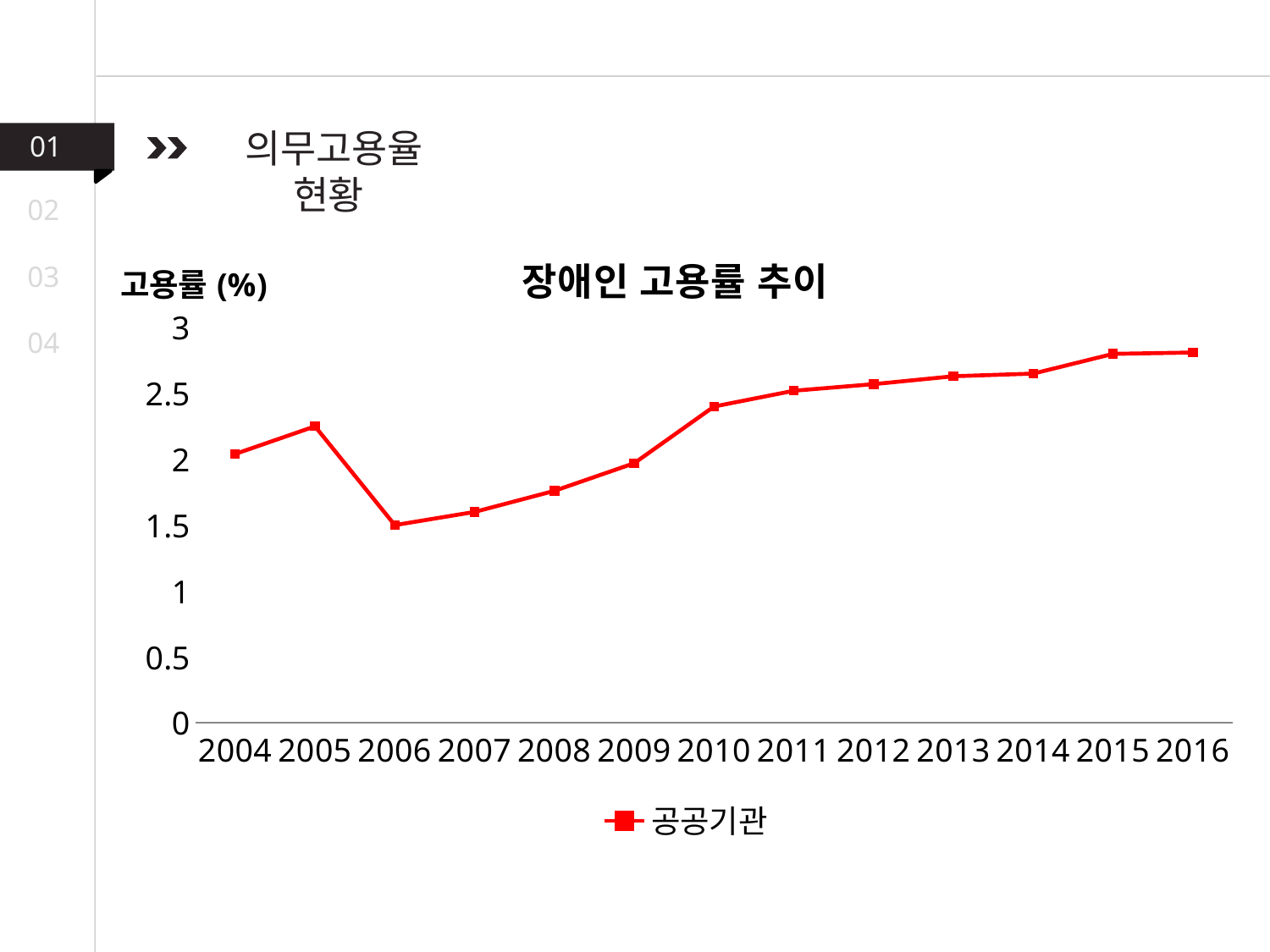
Is the value for 2006 greater or less than 2? less Is the value for 2015 greater or less than 2.5? greater Which year has the lowest employment rate? 2006 Is the value for 2005 greater or less than 2? greater What kind of chart is shown on the slide? line chart What is the title of the chart? 장애인 고용률 추이 Do the values rise or fall from 2006 to 2016? rise How many series does the legend list? 1 Which is larger, the value for 2005 or the value for 2006? 2005 What is the name of the series shown in the legend? 공공기관 How many years are plotted along the x axis? 13